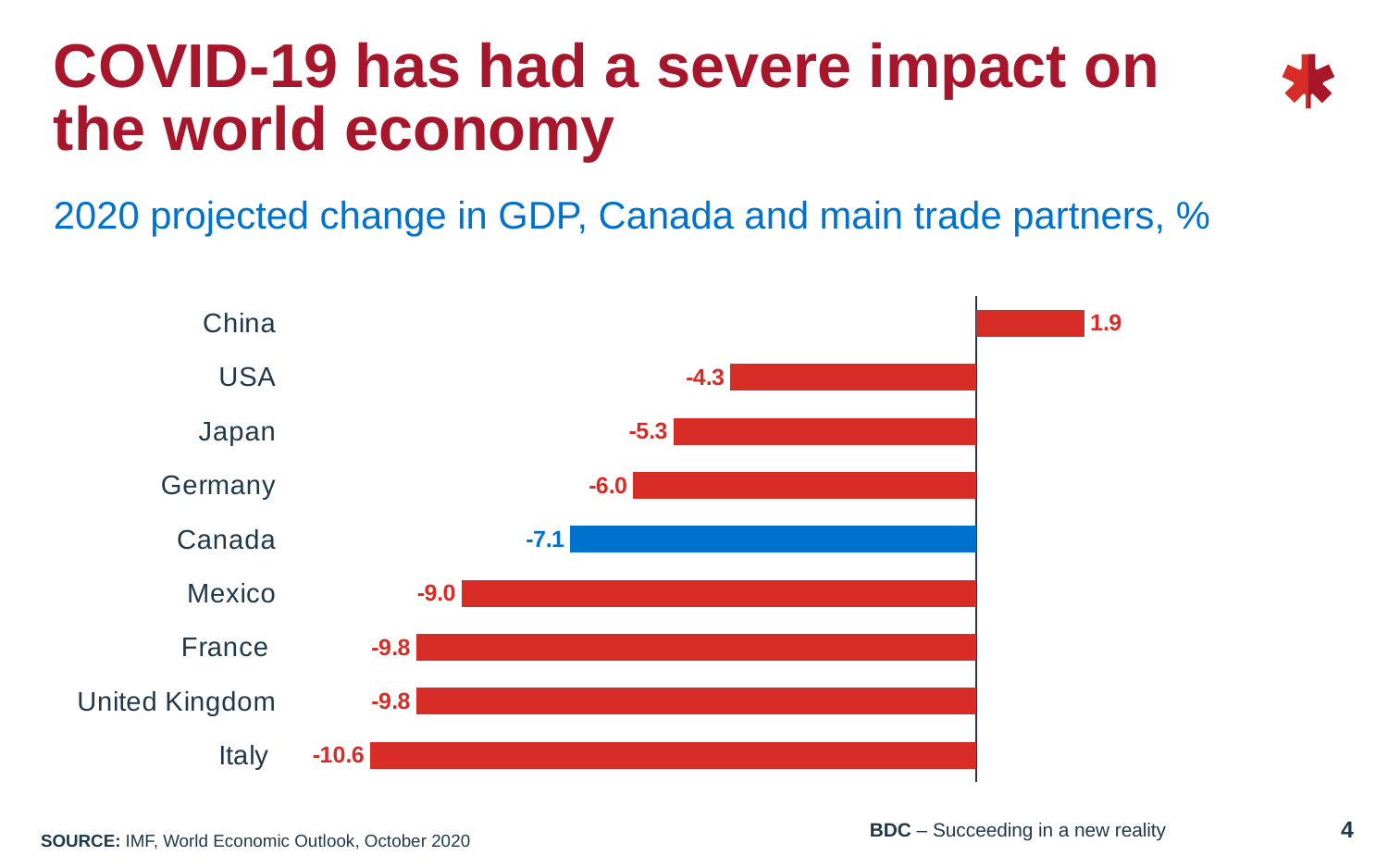
Which country has the lowest 2020 projected change in GDP? Italy Which country is the only one with a positive projected change in GDP? China What is the difference between the projected GDP change for the USA and for Canada? 2.8 What kind of chart is shown on the slide? Bar chart How many countries are shown in the chart? 9 What is the 2020 projected change in GDP for China? 1.9 Which country has the highest 2020 projected change in GDP? China What is the 2020 projected change in GDP for Canada? -7.1 What is the difference between the projected GDP change for Italy and for France? 0.8 What is the 2020 projected change in GDP for Mexico? -9.0 Which country's bar is coloured blue instead of red? Canada